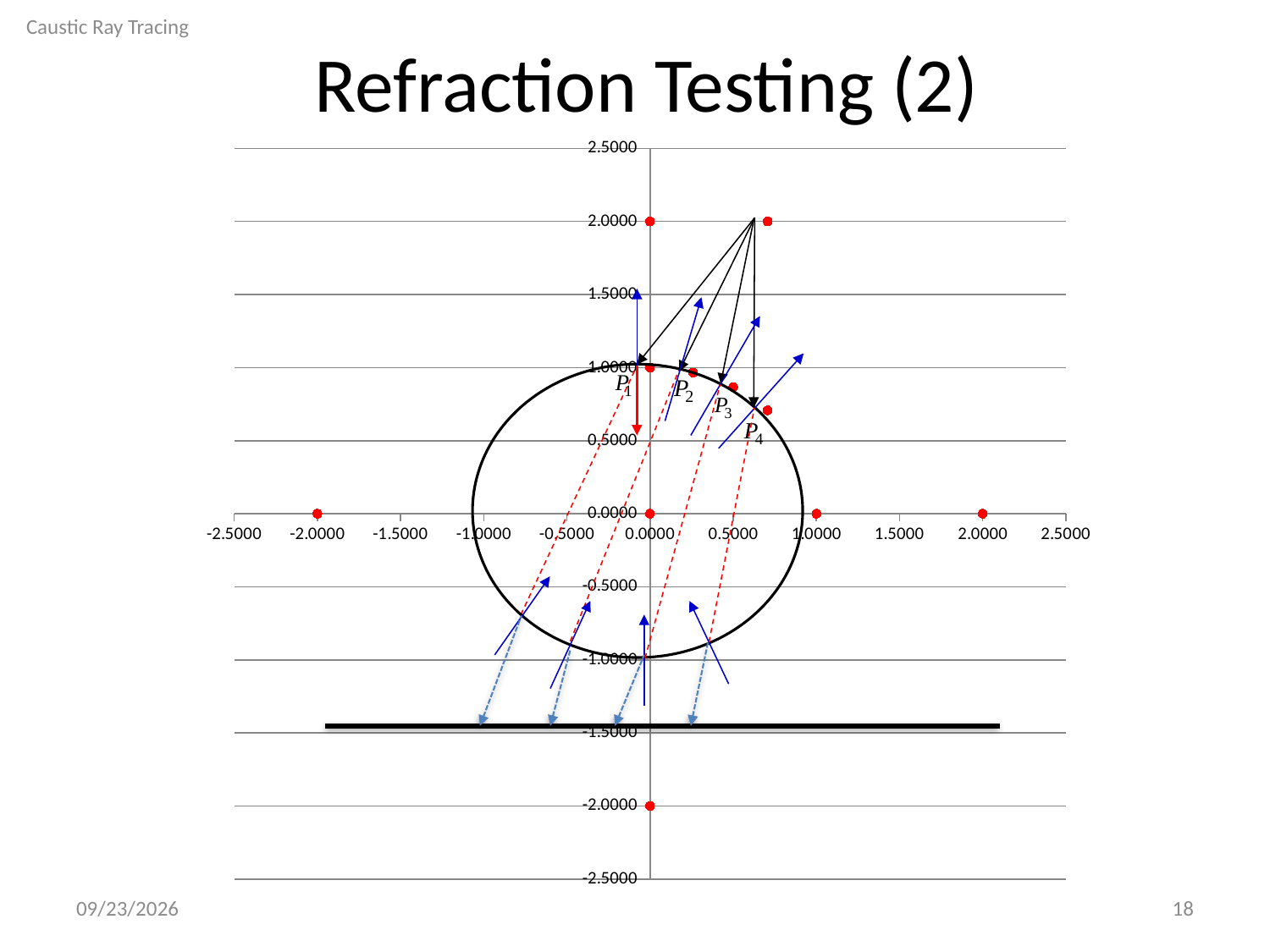
How many labeled points (P1 to P4) are marked on the circle in the chart? 4 What is the x value of the rightmost red point on the x axis? 2.0000 What is the maximum value shown on the chart's x axis? 2.5000 What is the title of the slide containing the chart? Refraction Testing (2) What is the minimum value shown on the chart's y axis? -2.5000 Is the y value of point P4 greater or less than 1.0000? less Which labeled point, P1 or P4, has the larger x value? P4 What kind of chart is shown on the slide? scatter chart Is the y value of point P1 greater or less than 0.5000? greater What is the y value of the red point lying on the y axis at the top of the chart? 2.0000 What is the y value of the lowest red point on the y axis? -2.0000 What is the x value of the leftmost red point on the x axis? -2.0000